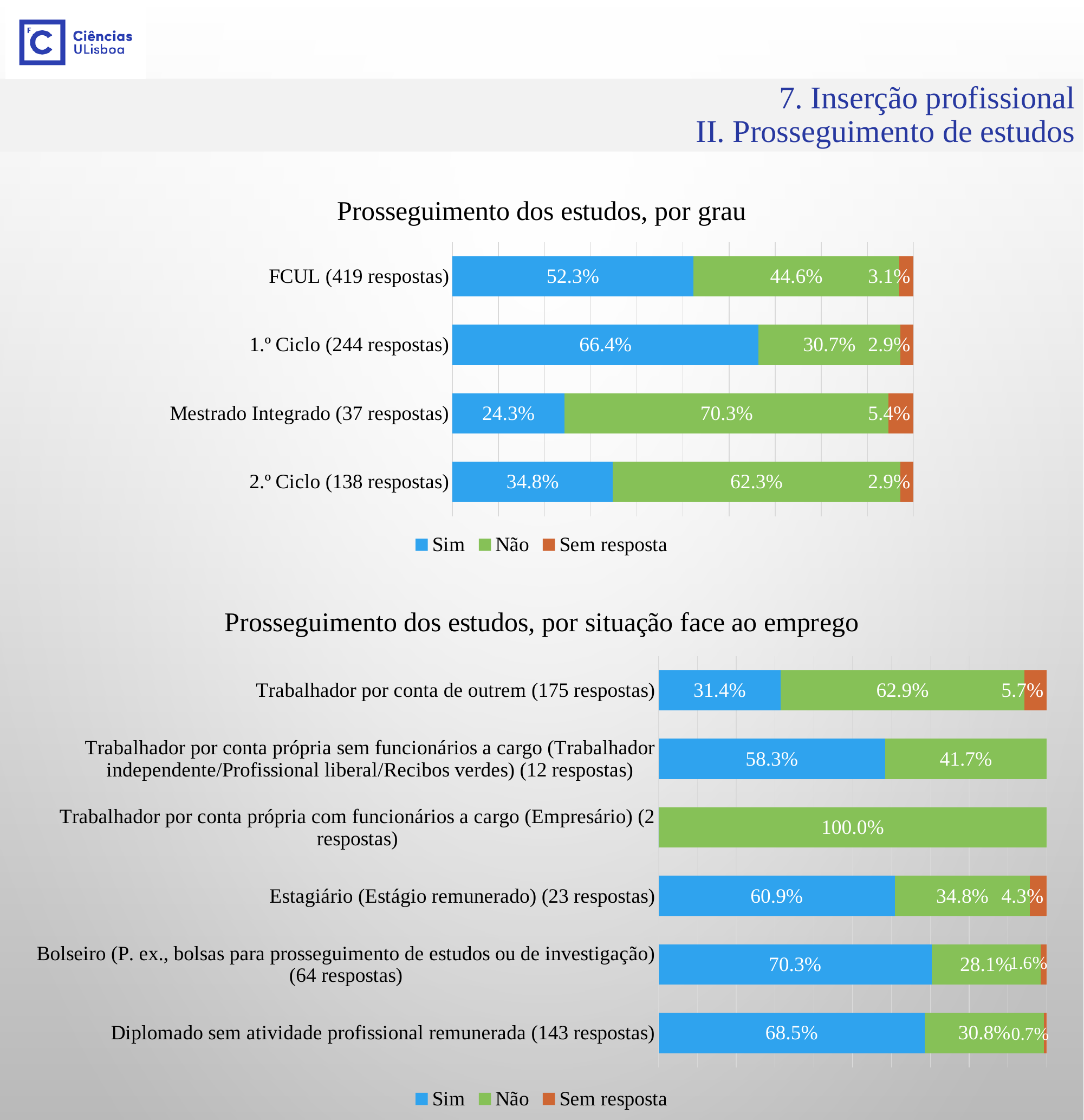
In the chart 'Prosseguimento dos estudos, por situação face ao emprego', what is the 'Sim' value for Bolseiro (64 respostas)? 70.3% In the chart 'Prosseguimento dos estudos, por grau', what is the 'Sim' value for 1.º Ciclo (244 respostas)? 66.4% What kind of chart is 'Prosseguimento dos estudos, por situação face ao emprego'? Stacked bar chart In the chart 'Prosseguimento dos estudos, por grau', which category has the lowest 'Sim' value? Mestrado Integrado (37 respostas) In the chart 'Prosseguimento dos estudos, por grau', what is the 'Não' value for Mestrado Integrado (37 respostas)? 70.3% How many series does the legend list in the chart 'Prosseguimento dos estudos, por situação face ao emprego'? 3 How many categories are shown in the chart 'Prosseguimento dos estudos, por grau'? 4 In the chart 'Prosseguimento dos estudos, por situação face ao emprego', which category has the highest 'Não' value? Trabalhador por conta própria com funcionários a cargo (Empresário) (2 respostas) In the chart 'Prosseguimento dos estudos, por situação face ao emprego', which has the larger 'Sim' value: Estagiário (23 respostas) or Diplomado sem atividade profissional remunerada (143 respostas)? Diplomado sem atividade profissional remunerada (143 respostas) In the chart 'Prosseguimento dos estudos, por grau', what is the difference between the 'Sim' value for 1.º Ciclo and the 'Sim' value for 2.º Ciclo? 31.6 percentage points In the chart 'Prosseguimento dos estudos, por situação face ao emprego', what is the 'Não' value for Trabalhador por conta de outrem (175 respostas)? 62.9% In the chart 'Prosseguimento dos estudos, por grau', which category has the highest 'Sim' value? 1.º Ciclo (244 respostas)